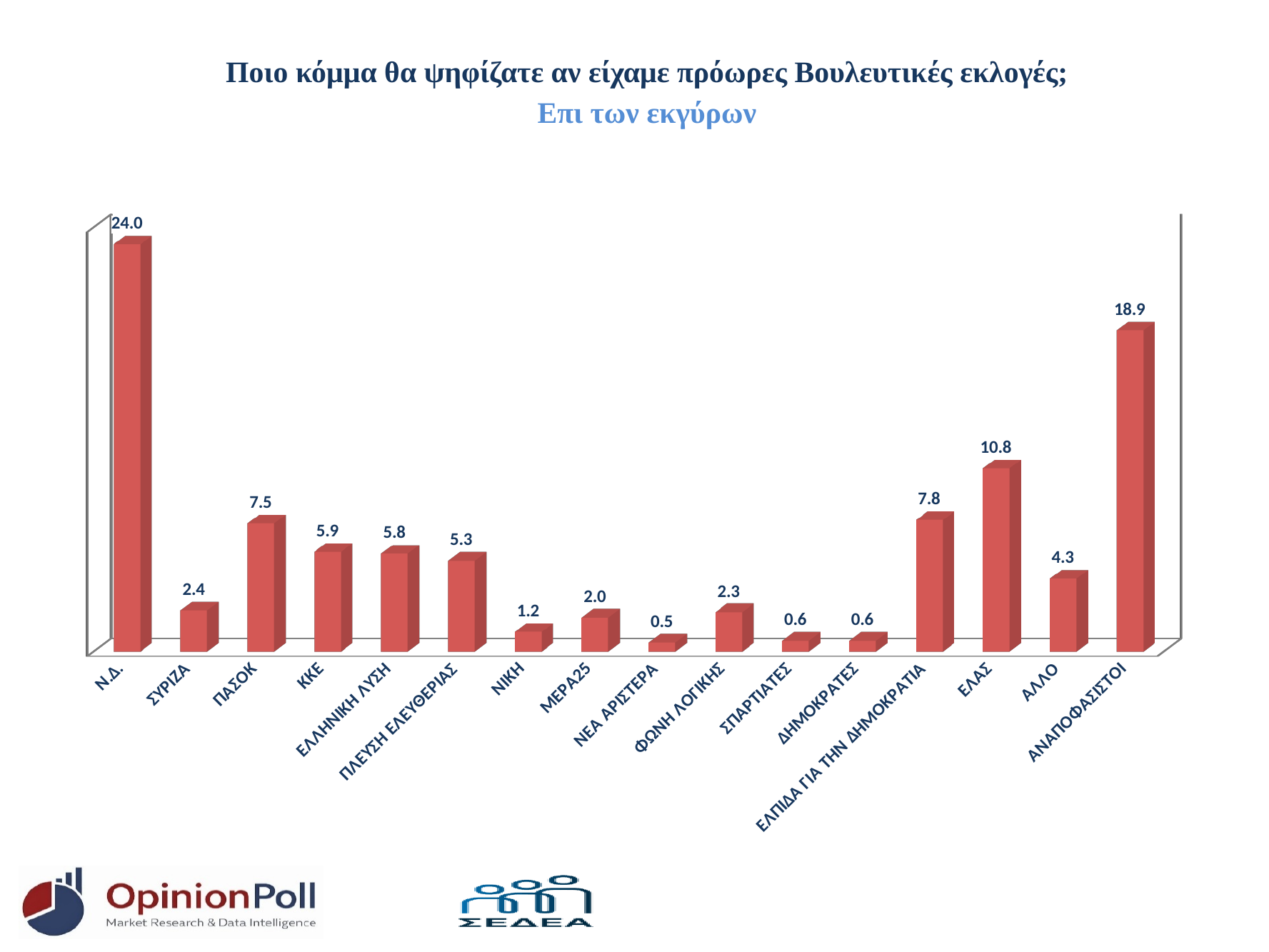
What value is shown for ΕΛΑΣ? 10.8 What kind of chart is shown on the slide? Bar chart What value is shown for ΠΛΕΥΣΗ ΕΛΕΥΘΕΡΙΑΣ? 5.3 Which category has the lowest value? ΝΕΑ ΑΡΙΣΤΕΡΑ What is the difference between the values for ΠΑΣΟΚ and ΚΚΕ? 1.6 What value is shown for ΑΝΑΠΟΦΑΣΙΣΤΟΙ? 18.9 How many categories are shown on the x axis? 16 Which category has the highest value? Ν.Δ. Which has a larger value, ΕΛΠΙΔΑ ΓΙΑ ΤΗΝ ΔΗΜΟΚΡΑΤΙΑ or ΠΑΣΟΚ? ΕΛΠΙΔΑ ΓΙΑ ΤΗΝ ΔΗΜΟΚΡΑΤΙΑ What is the difference between the values for Ν.Δ. and ΑΝΑΠΟΦΑΣΙΣΤΟΙ? 5.1 What value is shown for Ν.Δ.? 24.0 What is the subtitle shown below the chart title? Επι των εκγύρων